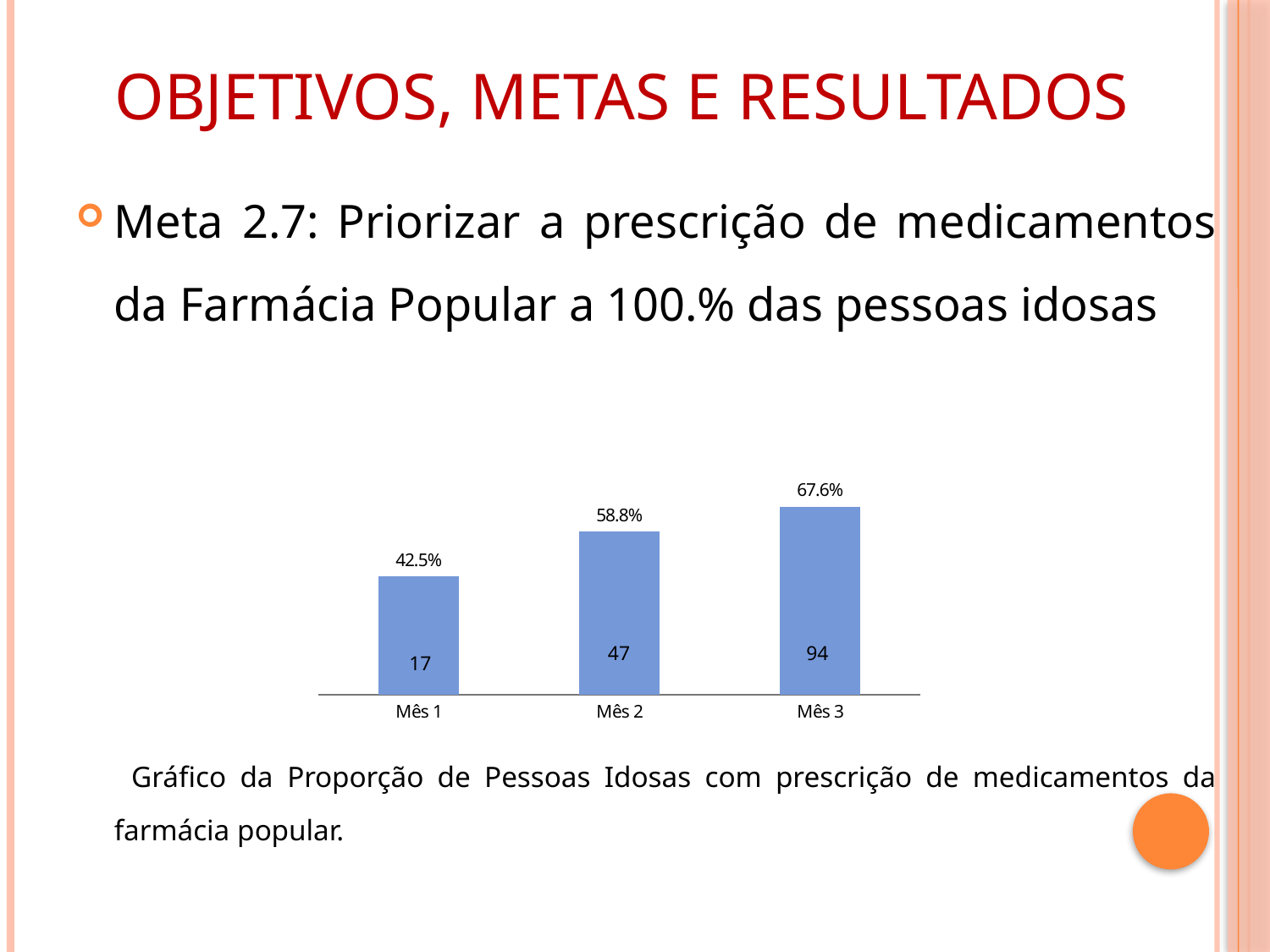
What percentage is shown above the bar for Mês 1? 42.5% What number is printed inside the bar for Mês 3? 94 Which has a higher percentage, Mês 1 or Mês 2? Mês 2 How many months are shown on the chart? 3 What number is printed inside the bar for Mês 1? 17 What kind of chart is shown on the slide? Bar chart What is the difference between the numbers printed inside the bars for Mês 2 and Mês 1? 30 Which month has the highest percentage? Mês 3 What percentage is shown above the bar for Mês 3? 67.6% What is the difference in percentage points between Mês 3 and Mês 1? 25.1 What percentage is shown above the bar for Mês 2? 58.8% Which month has the lowest percentage? Mês 1